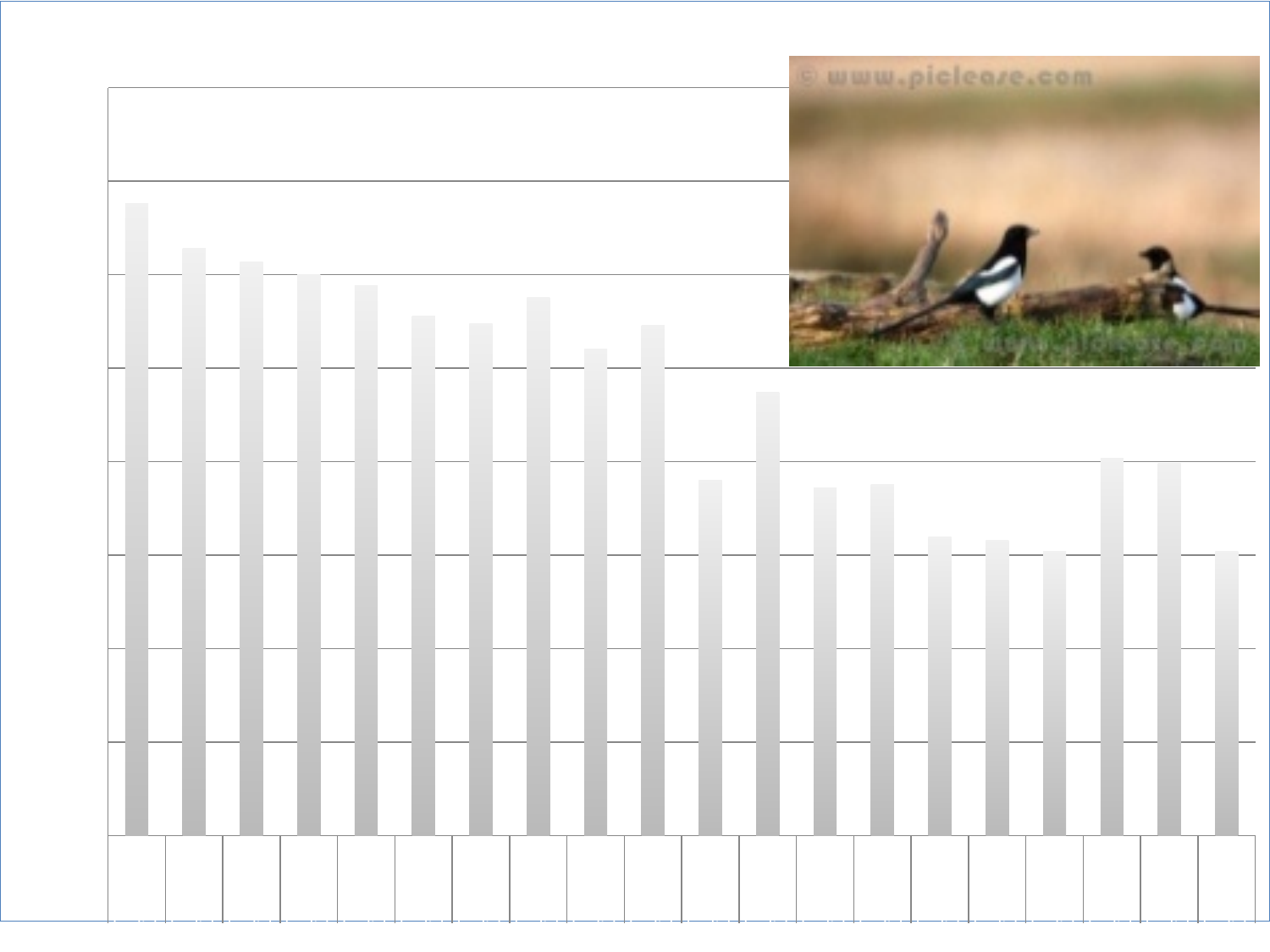
Is the first (leftmost) bar taller or shorter than the last (rightmost) bar? taller Do the bar values generally rise or fall from left to right across the chart? fall Which bar is the tallest in the chart, the leftmost bar or the rightmost bar? the leftmost bar How many bars does the chart contain? 20 Does the chart display a legend? No Does the chart display a title? No What kind of chart is shown on the slide? bar chart